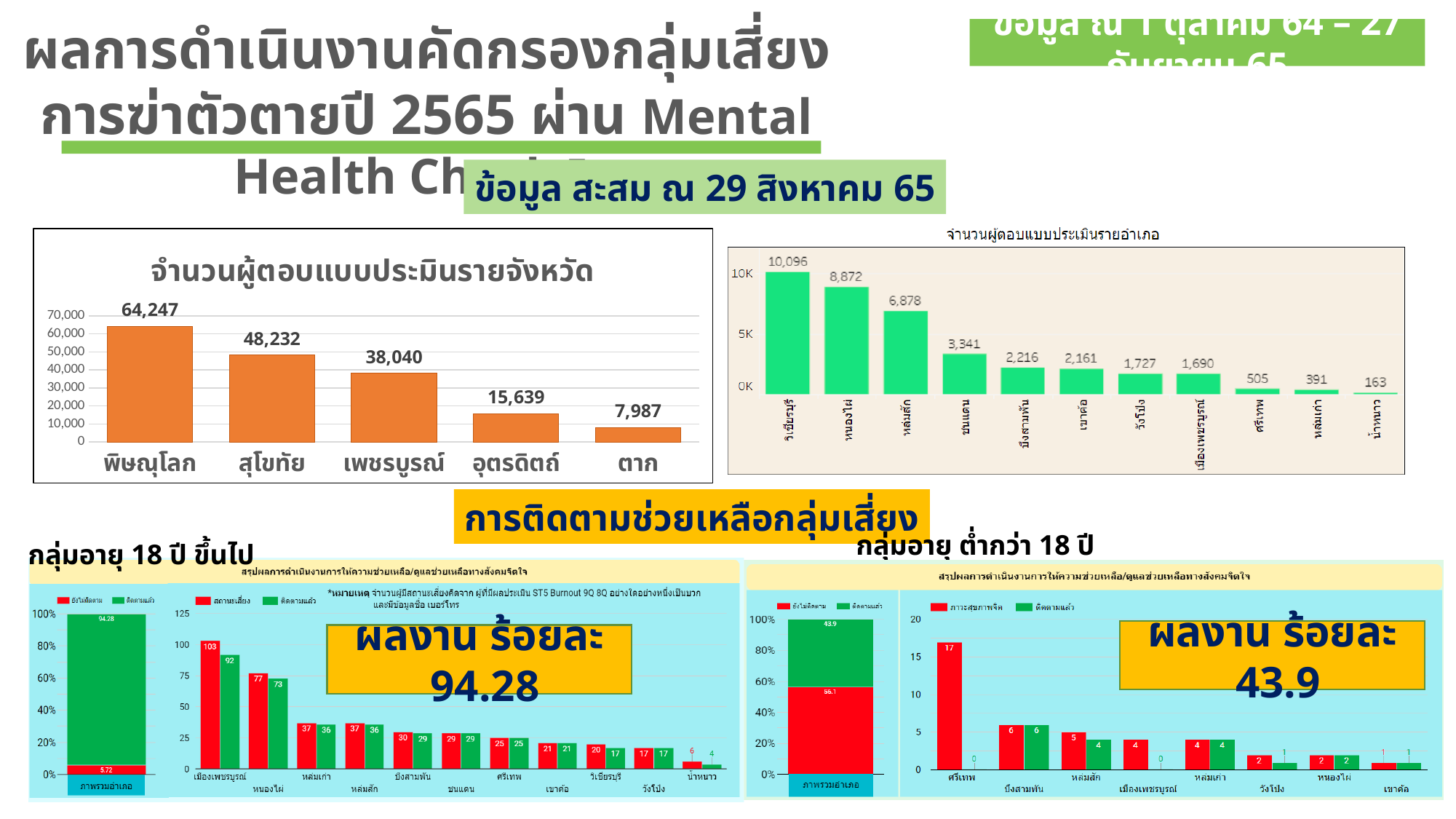
In the chart titled จำนวนผู้ตอบแบบประเมินรายจังหวัด, do the values rise or fall from left to right? fall In the chart titled จำนวนผู้ตอบแบบประเมินรายอำเภอ, what is the value for น้ำหนาว? 163 In the chart titled จำนวนผู้ตอบแบบประเมินรายจังหวัด, which province has the lowest value? ตาก In the chart titled จำนวนผู้ตอบแบบประเมินรายจังหวัด, what is the difference between สุโขทัย and เพชรบูรณ์? 10,192 In the chart titled จำนวนผู้ตอบแบบประเมินรายอำเภอ, which district has the highest value? วิเชียรบุรี In the chart titled จำนวนผู้ตอบแบบประเมินรายอำเภอ, which is larger, the value for ศรีเทพ or the value for หล่มเก่า? ศรีเทพ In the stacked bar chart at the bottom left (กลุ่มอายุ 18 ปี ขึ้นไป), what is the value of the green segment? 94.28 What kind of chart is the chart titled จำนวนผู้ตอบแบบประเมินรายอำเภอ? bar chart In the chart titled จำนวนผู้ตอบแบบประเมินรายจังหวัด, how many provinces are shown? 5 In the chart titled จำนวนผู้ตอบแบบประเมินรายจังหวัด, what is the value for พิษณุโลก? 64,247 In the chart titled จำนวนผู้ตอบแบบประเมินรายอำเภอ, what is the value for หล่มสัก? 6,878 In the bar chart at the bottom right (กลุ่มอายุ ต่ำกว่า 18 ปี), what is the red bar value for ศรีเทพ? 17